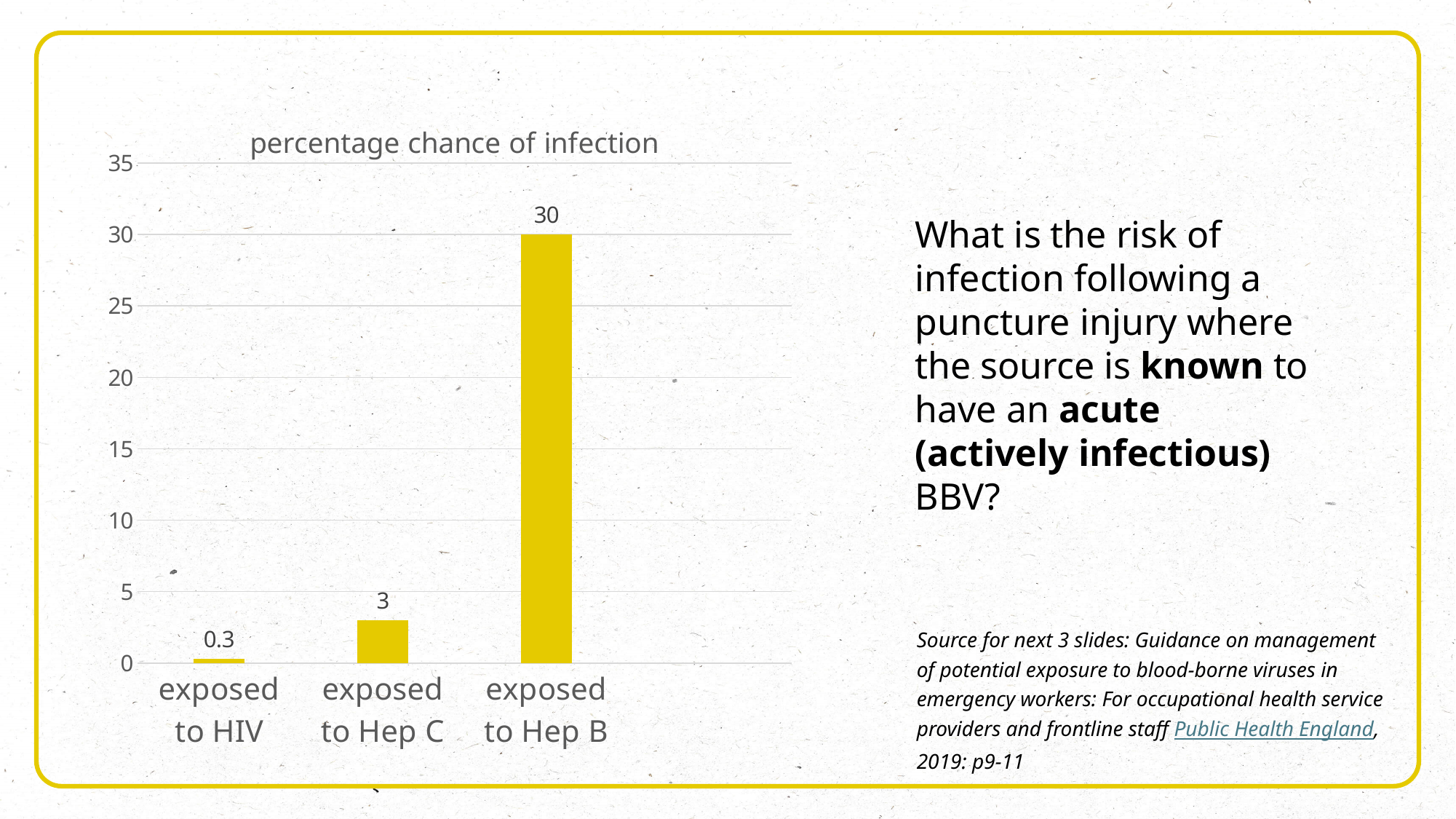
What is the percentage chance of infection when exposed to HIV? 0.3 What is the percentage chance of infection when exposed to Hep B? 30 What is the title of the chart? percentage chance of infection What is the difference between the percentage chance of infection for Hep C and HIV? 2.7 What type of chart is shown on the slide? bar chart Which has a higher percentage chance of infection, exposure to Hep C or exposure to HIV? exposed to Hep C Which exposure has the highest percentage chance of infection? exposed to Hep B What is the percentage chance of infection when exposed to Hep C? 3 Is the value for exposed to Hep B greater or less than 25? greater Which exposure has the lowest percentage chance of infection? exposed to HIV How many exposure categories are shown in the chart? 3 What is the difference between the percentage chance of infection for Hep B and Hep C? 27